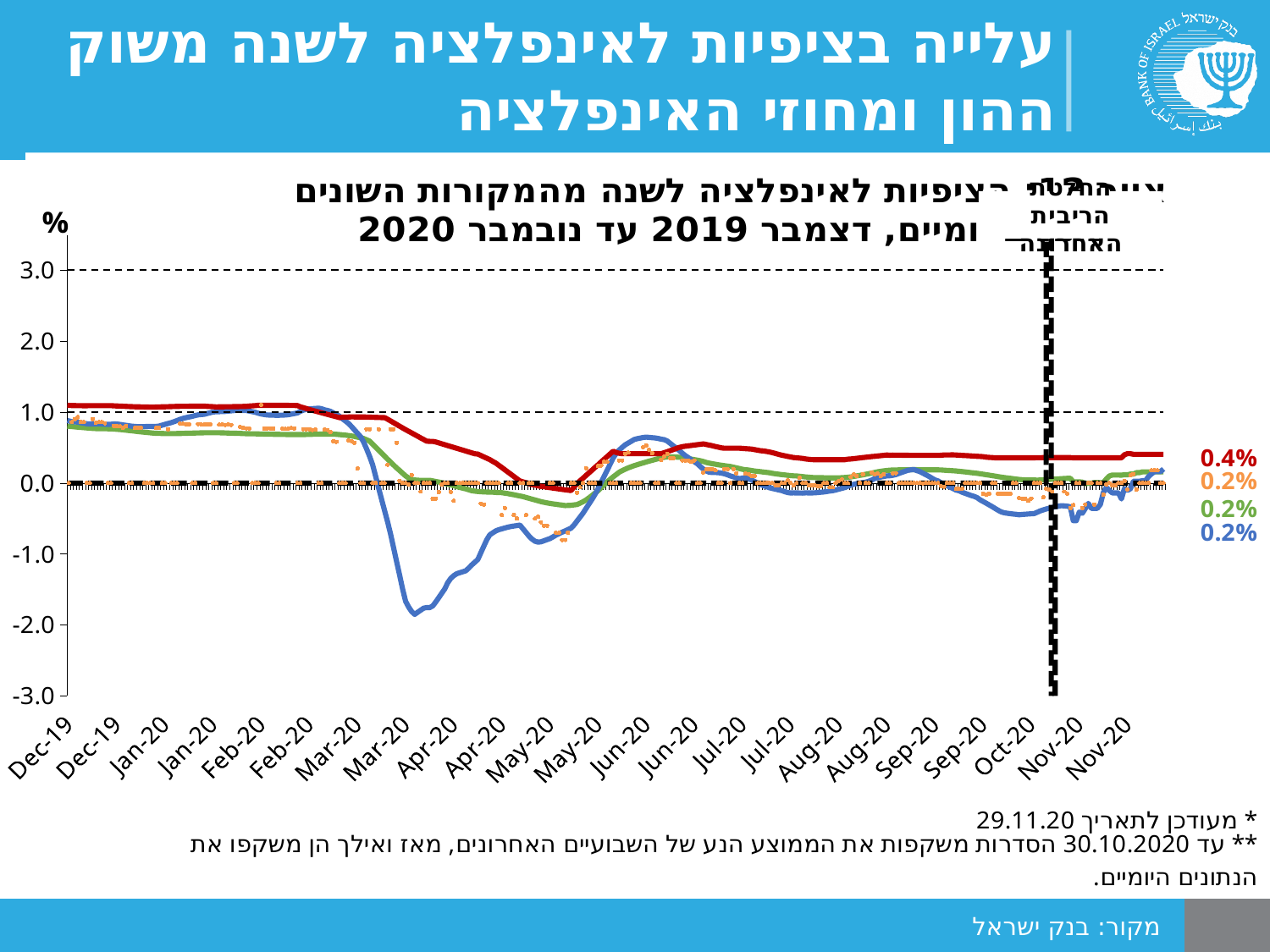
Is the lowest point of the blue line, around April 2020, greater or less than -1.0? less How many lines are plotted on the chart? 4 What is the highest value shown on the vertical axis? 3.0 Does the red line rise or fall overall from December 2019 to November 2020? fall Which line has the highest labelled value at the end of the period? the red line (0.4%) Is the value of the red line in June 2020 greater or less than 1.0? less What is the source cited at the bottom of the slide? בנק ישראל (Bank of Israel) What is the end-of-period value labelled for the red line? 0.4% What is the difference between the labelled end values of the red line and the green line? 0.2 percentage points What is the end-of-period value labelled for the blue line? 0.2% What kind of chart is shown on the slide? line chart At the end of the period, is the labelled value of the red line larger or smaller than that of the orange line? larger